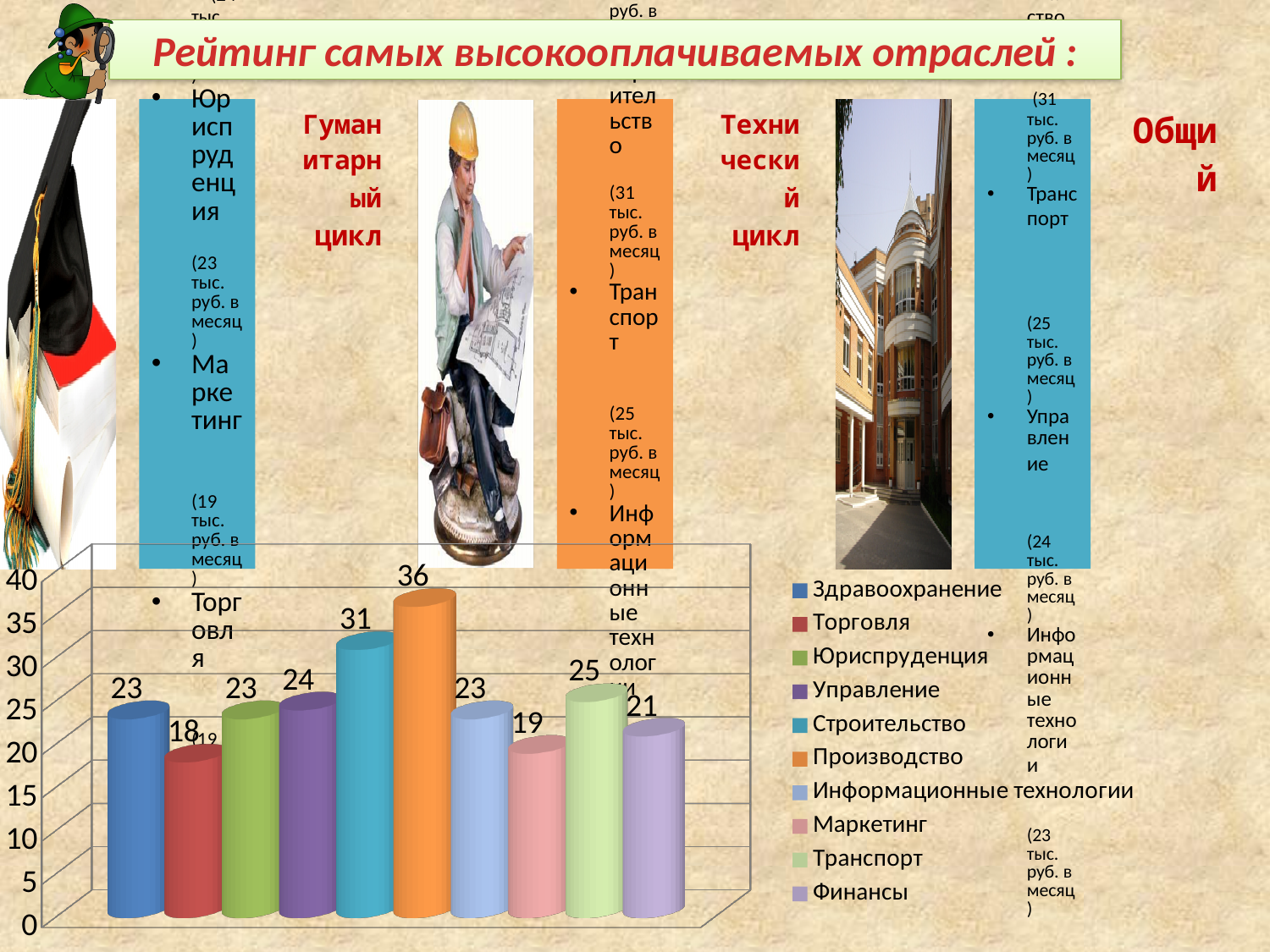
How many entries does the chart legend list? 10 What value is shown for Производство in the bar chart? 36 What is the difference between the values for Транспорт and Маркетинг? 6 What kind of chart is shown on the slide? bar chart Which category has the lowest bar in the chart? Торговля Which is larger, the value for Транспорт or the value for Финансы? Транспорт What value is shown for Строительство in the bar chart? 31 Is the value for Производство greater or less than 35? greater Which category has the highest bar in the chart? Производство How many bars are plotted in the chart? 10 What is the difference between the values for Производство and Строительство? 5 What value is shown for Управление in the bar chart? 24